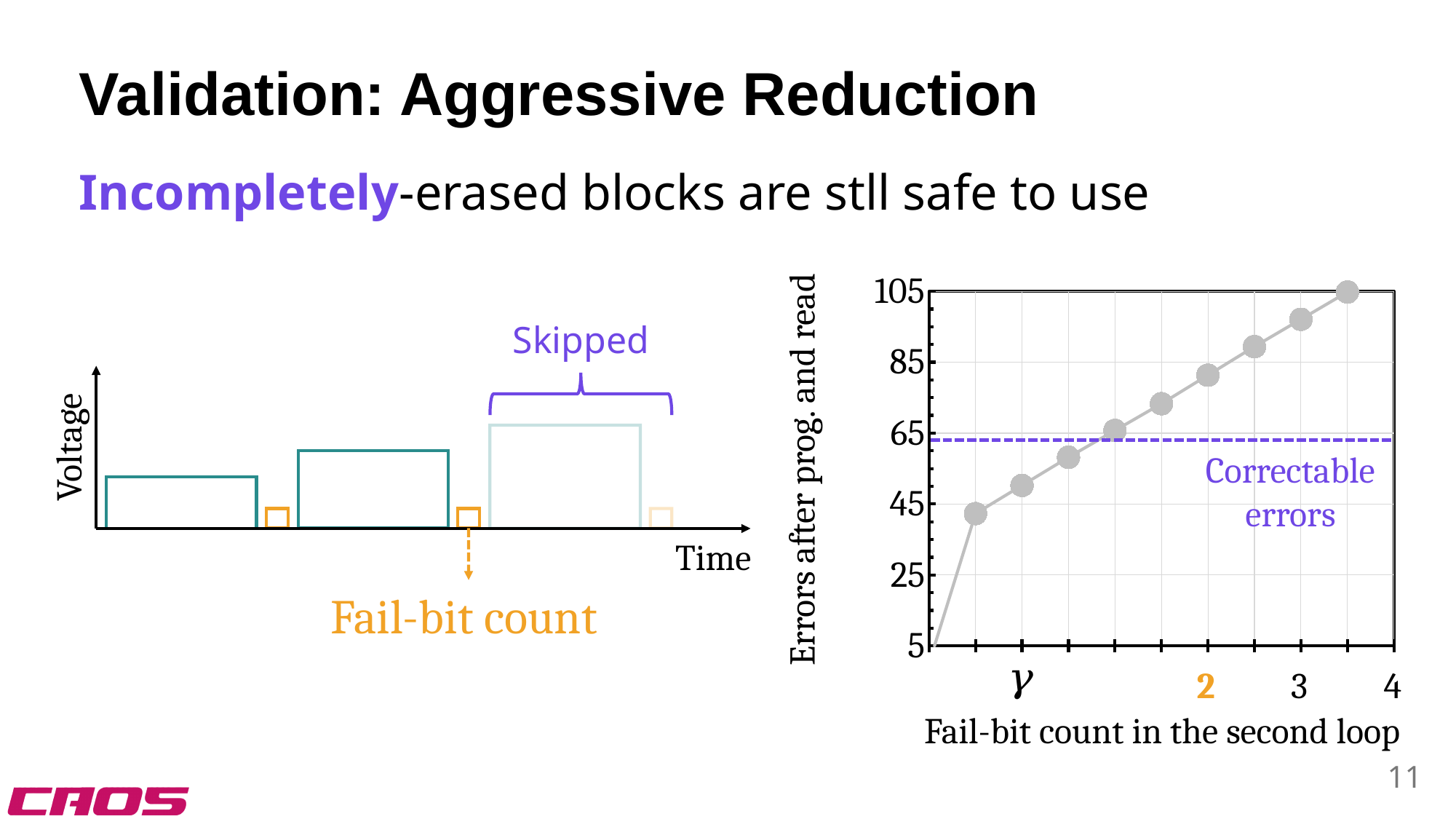
In the right-hand chart, which has more errors: fail-bit count 2 or fail-bit count 3? 3 In the right-hand chart, do the errors rise or fall as the fail-bit count in the second loop increases? rise In the right-hand chart, which labeled fail-bit count has the highest number of errors? 3 How many circular data markers are plotted in the right-hand chart? 9 In the right-hand chart, is the value for fail-bit count γ greater or less than 65? less What is the y-axis label of the right-hand chart? Errors after prog. and read What does the dashed horizontal line in the right-hand chart represent? Correctable errors In the right-hand chart, is the value for fail-bit count 3 greater or less than 85? greater In the right-hand chart, is the point at fail-bit count γ above or below the dashed 'Correctable errors' line? below What kind of chart is shown on the right side of the slide? line chart In the right-hand chart, is the value for fail-bit count 2 greater or less than 65? greater